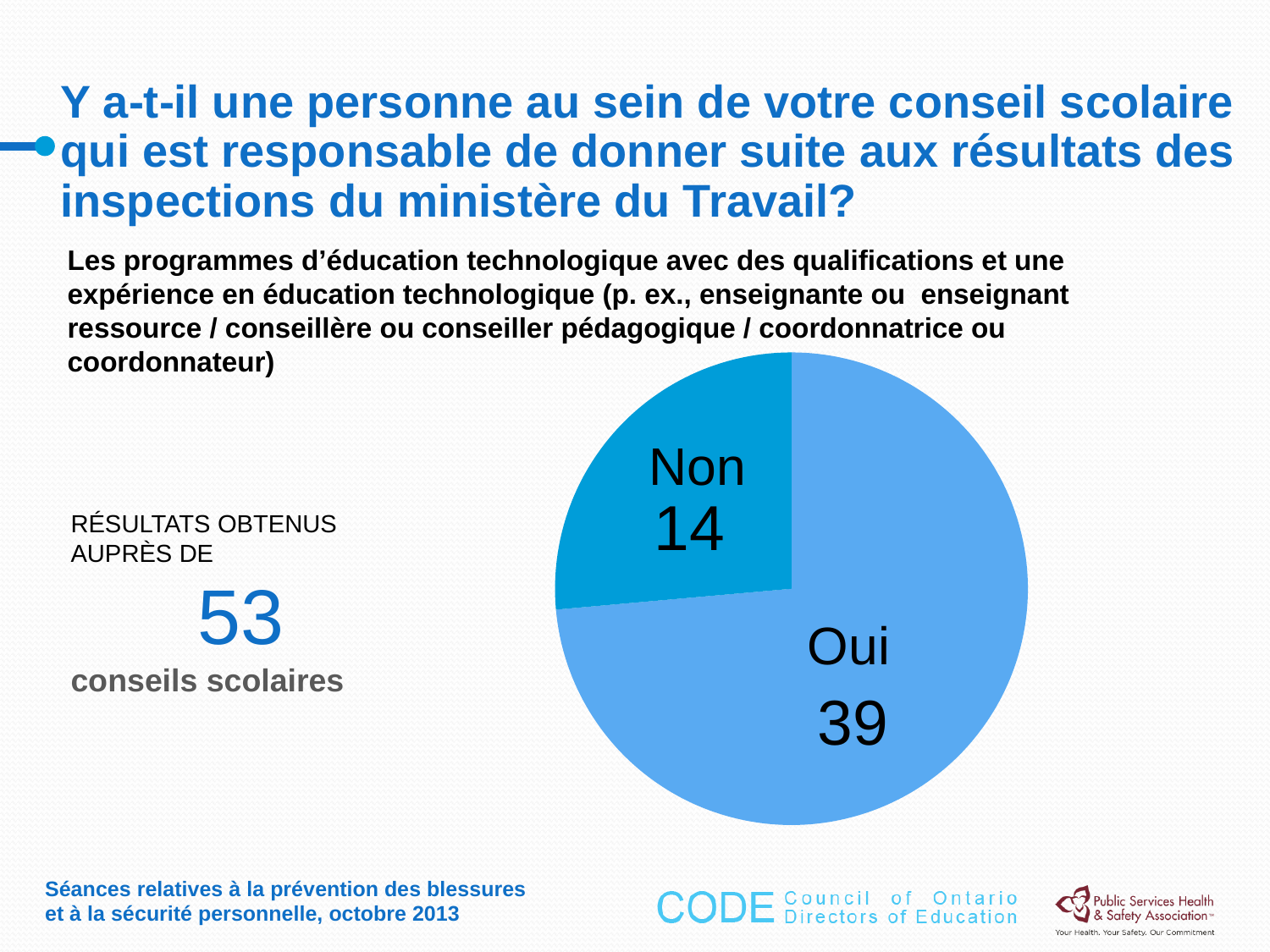
Which slice of the pie chart is the largest? Oui What is the difference between the number of "Oui" and "Non" responses in the pie chart? 25 Which is larger in the pie chart, the "Oui" slice or the "Non" slice? Oui What share of the 53 responses does the "Oui" slice represent? 39 out of 53 How many slices does the pie chart have? 2 Which slice of the pie chart is shown in the darker blue colour? Non What is the total of the two slices in the pie chart? 53 Which slice of the pie chart is the smallest? Non How many school boards answered "Oui" according to the pie chart? 39 How many school boards answered "Non" according to the pie chart? 14 How many school boards are the results in the pie chart based on, according to the text on the slide? 53 What type of chart is shown on the slide? pie chart